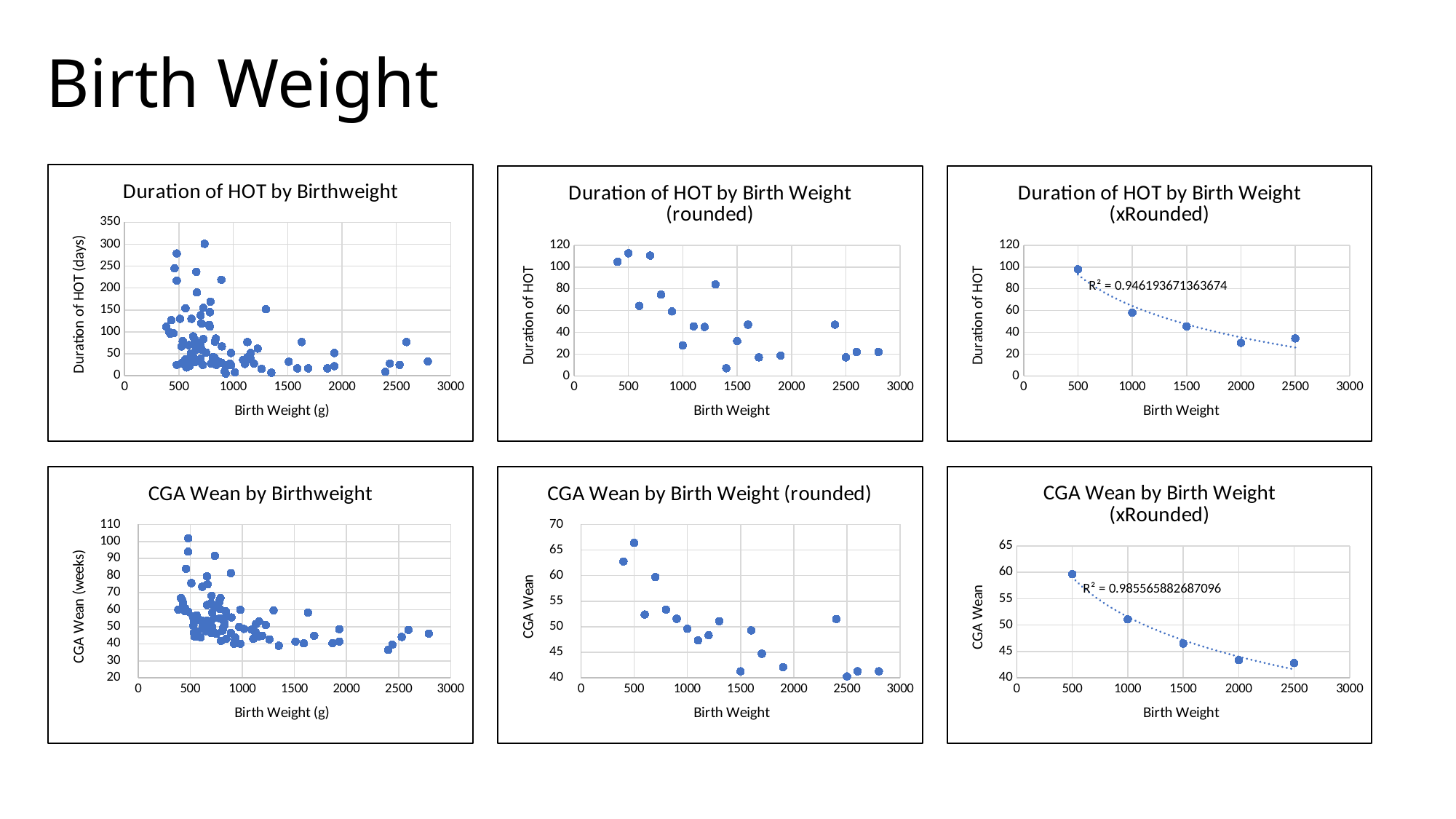
What kind of chart is "Duration of HOT by Birthweight"? scatter chart In the "Duration of HOT by Birth Weight (xRounded)" chart, what R² value is shown? 0.946193671363674 In the "CGA Wean by Birth Weight (xRounded)" chart, what R² value is shown? 0.985565882687096 In the "CGA Wean by Birth Weight (xRounded)" chart, do the values rise or fall as birth weight increases? fall In the "Duration of HOT by Birth Weight (xRounded)" chart, is the value at birth weight 2500 greater or less than 40? less In the "Duration of HOT by Birth Weight (xRounded)" chart, how many data points are plotted? 5 In the "Duration of HOT by Birth Weight (xRounded)" chart, is the value at birth weight 500 greater or less than 80? greater In the "CGA Wean by Birth Weight (xRounded)" chart, is the value at birth weight 500 greater or less than 55? greater In the "Duration of HOT by Birth Weight (xRounded)" chart, do the values rise or fall as birth weight increases? fall In the "CGA Wean by Birth Weight (xRounded)" chart, how many data points are plotted? 5 In the "CGA Wean by Birth Weight (xRounded)" chart, which is larger, the value at birth weight 1000 or at 2000? 1000 In the "Duration of HOT by Birth Weight (xRounded)" chart, which birth weight has the highest duration of HOT? 500